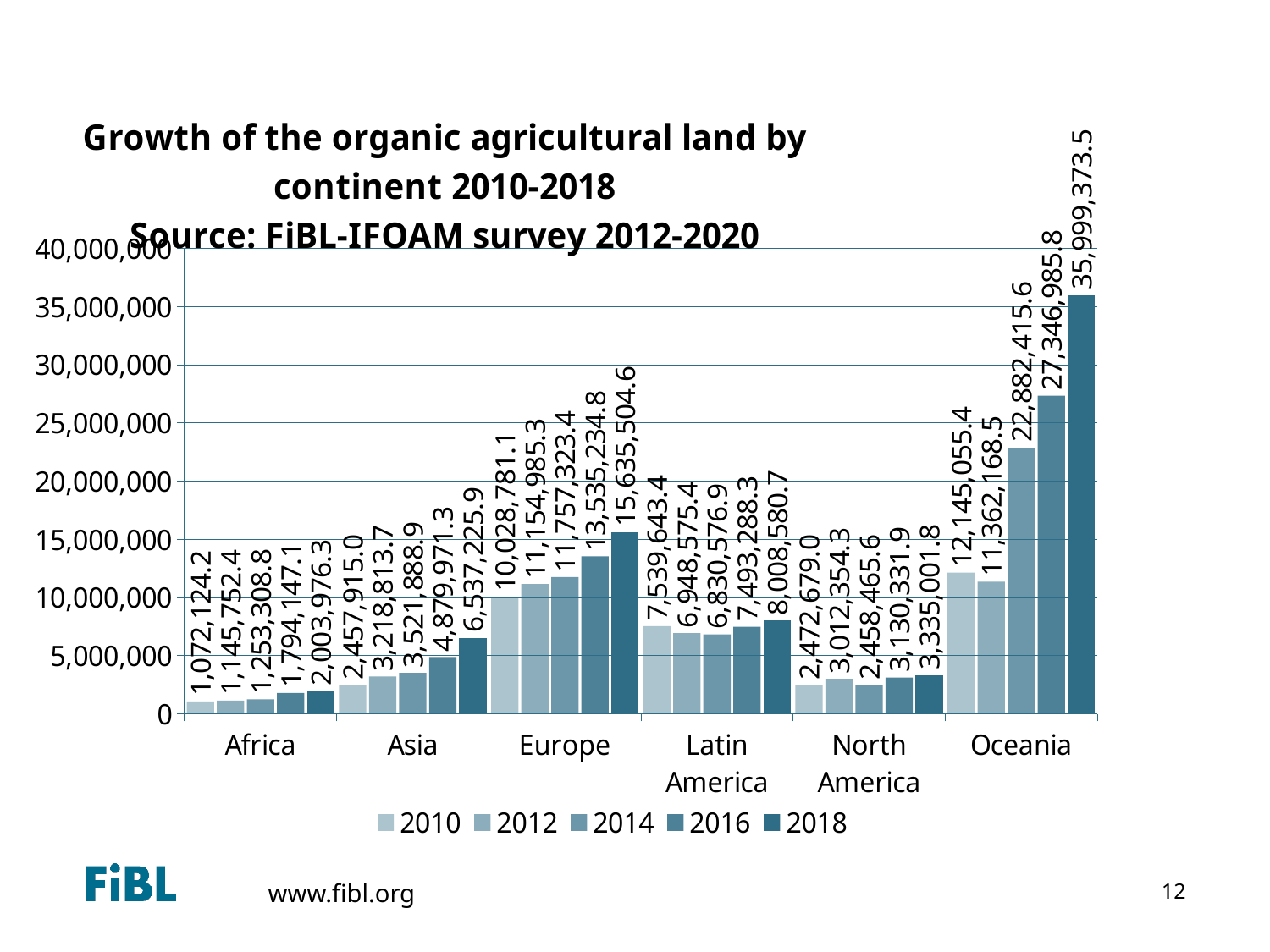
What is the difference between the Europe values for 2018 and 2010? 5,606,723.5 Which continent has the lowest value in 2010? Africa What is the value for Oceania in 2018? 35,999,373.5 Which continent has the highest value in 2018? Oceania What is the difference between the Oceania values for 2018 and 2016? 8,652,387.7 What kind of chart is shown on the slide? Bar chart Which is larger, the 2018 value for Asia or the 2018 value for North America? Asia Do the values for Asia rise or fall from 2010 to 2018? Rise What is the value for Europe in 2014? 11,757,323.4 What is the value for Latin America in 2012? 6,948,575.4 How many series does the legend list? 5 What is the value for Africa in 2010? 1,072,124.2